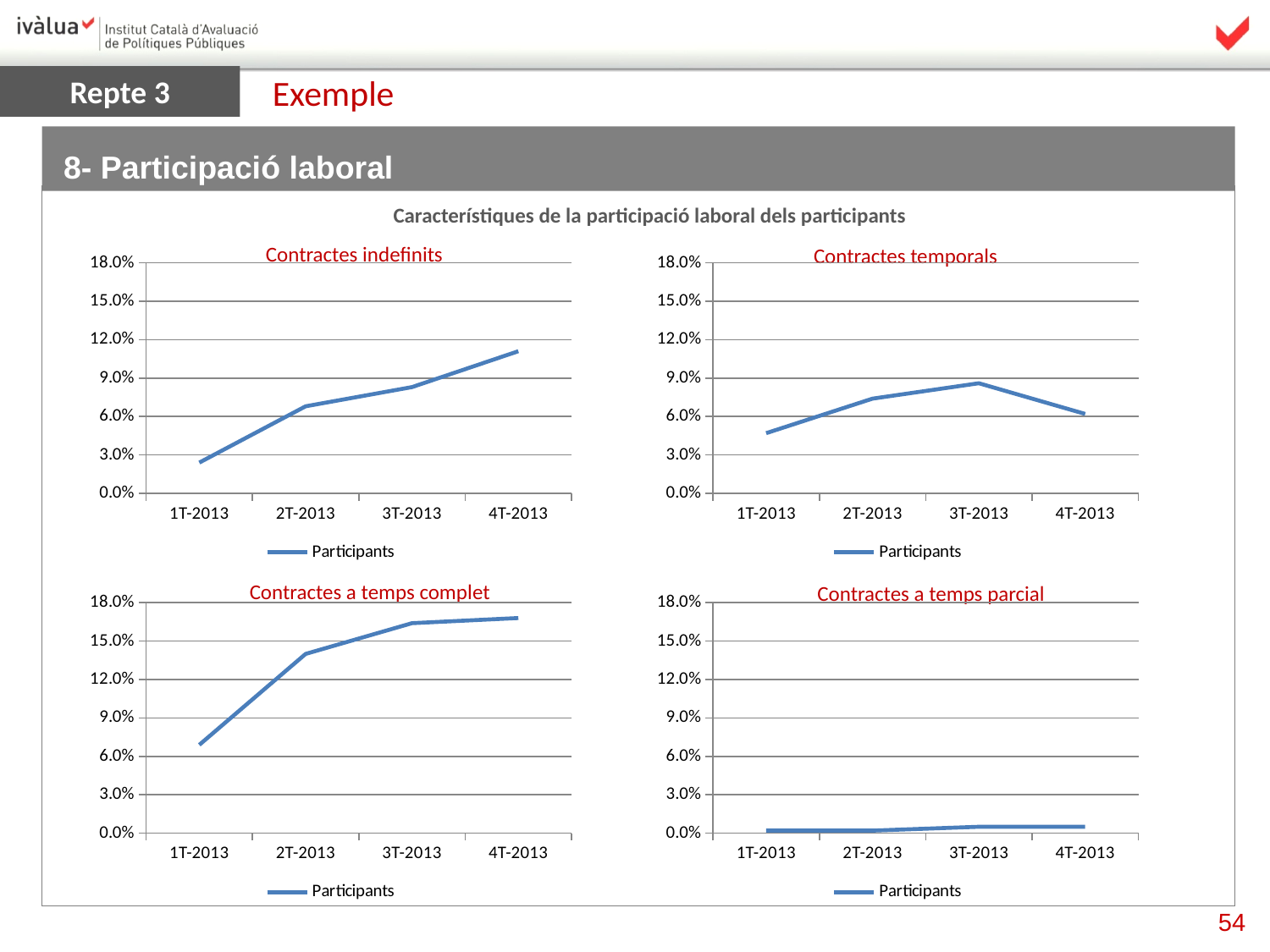
In the 'Contractes indefinits' chart, is the value for 4T-2013 greater or less than 9.0%? greater In the 'Contractes a temps complet' chart, is the value for 2T-2013 greater or less than 12.0%? greater How many quarters are plotted on the x axis of the 'Contractes temporals' chart? 4 In the 'Contractes temporals' chart, which is larger: the value for 2T-2013 or the value for 1T-2013? 2T-2013 What kind of chart is the 'Contractes indefinits' chart? line chart In the 'Contractes temporals' chart, which quarter has the lowest value? 1T-2013 In the 'Contractes temporals' chart, which quarter has the highest value? 3T-2013 In the 'Contractes indefinits' chart, do the values rise or fall from 1T-2013 to 4T-2013? rise In the 'Contractes a temps complet' chart, which quarter has the lowest value? 1T-2013 What is the name of the series shown in the legend of the 'Contractes a temps parcial' chart? Participants In the 'Contractes a temps parcial' chart, is the value for 4T-2013 greater or less than 3.0%? less How many series does the legend of the 'Contractes a temps complet' chart list? 1